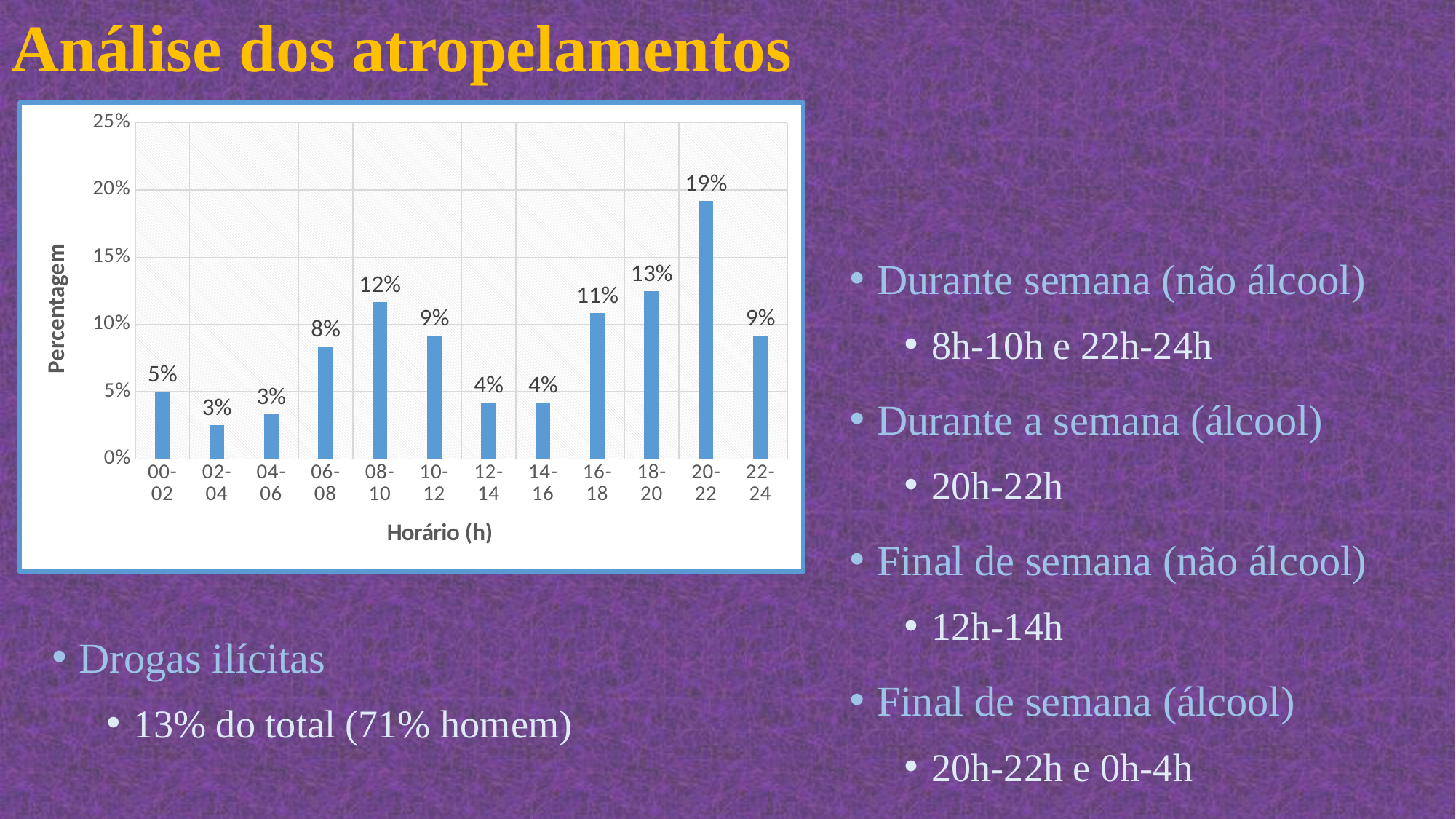
What kind of chart is shown on the slide? bar chart What is the value for the 00-02 time slot? 5% What is the value for the 20-22 time slot? 19% Which is larger, the value for 16-18 or the value for 10-12? 16-18 What is the value for the 08-10 time slot? 12% Is the value for 06-08 greater or less than 5%? greater How many time slots are shown on the x axis? 12 What is the label of the y axis? Percentagem Do the values rise or fall from 12-14 to 20-22? rise What is the difference between the values for 20-22 and 18-20? 6% What is the label of the x axis? Horário (h) Which time slot has the highest percentage? 20-22